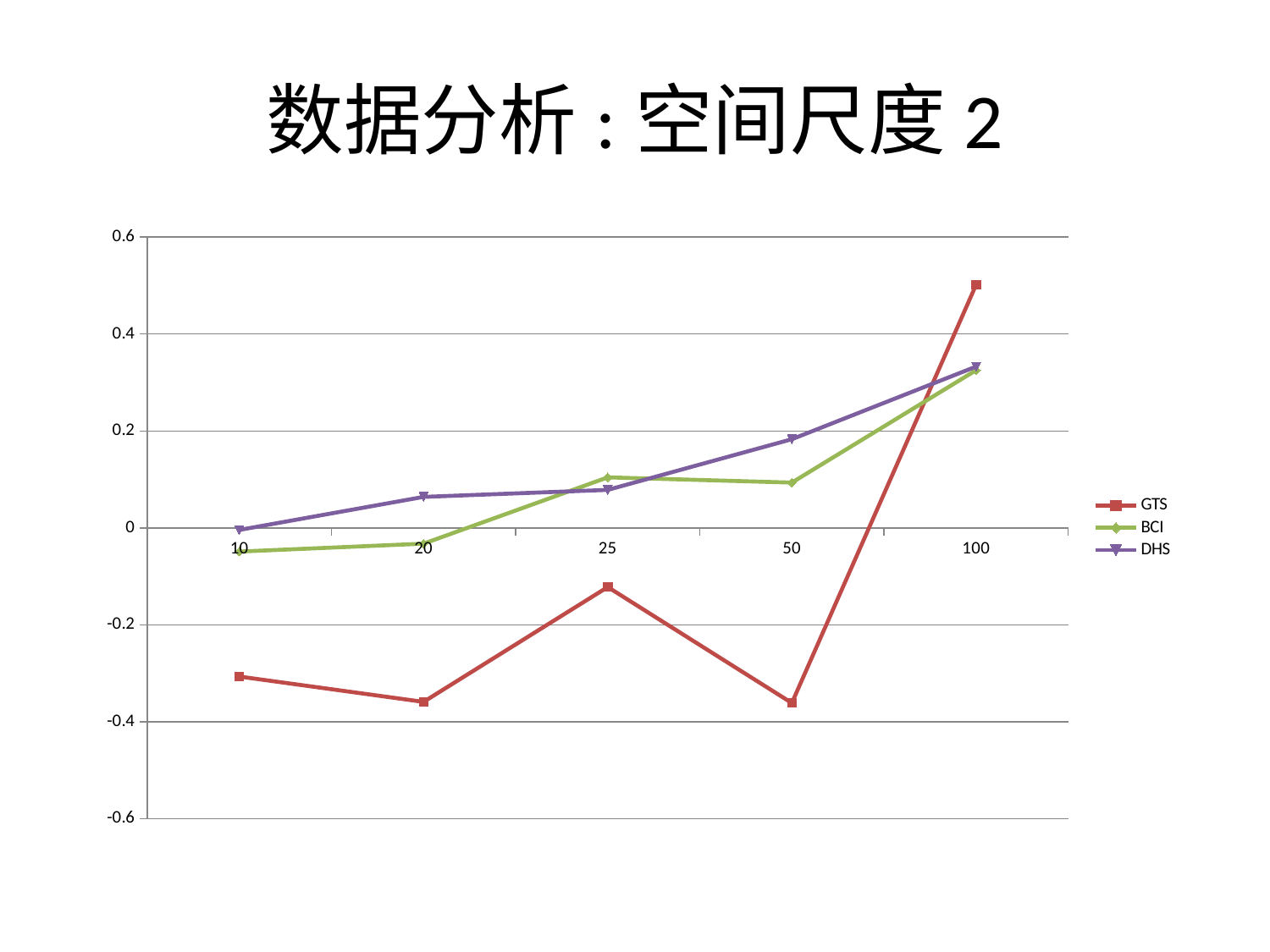
How many points are plotted along the x axis for each series? 5 Is the value for GTS at x = 100 greater or less than 0.4? greater What kind of chart is shown on the slide? line chart At which x value does the GTS series reach its highest point? 100 Is the value for GTS at x = 20 greater or less than -0.2? less At x = 50, which series has the larger value, DHS or BCI? DHS Is the value for BCI at x = 100 greater or less than 0.2? greater What are the names of the three series in the legend? GTS, BCI, DHS How many series does the legend list? 3 Does the DHS series rise or fall as x increases from 10 to 100? rise Which series has the lowest value at x = 10? GTS Which series has the highest value at x = 100? GTS